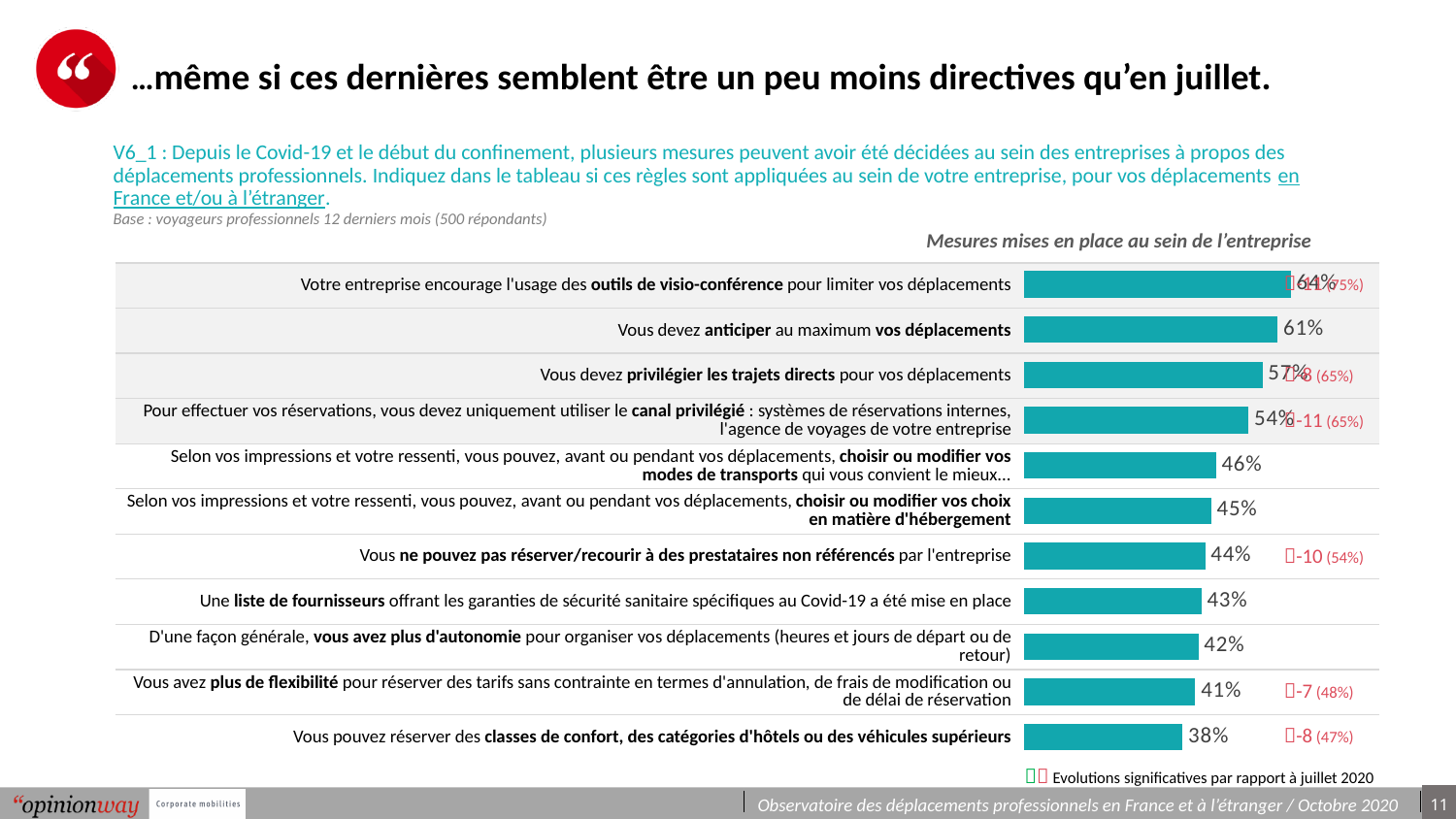
Which measure has the lowest percentage in the chart? Vous pouvez réserver des classes de confort, des catégories d'hôtels ou des véhicules supérieurs How many measures (bars) are shown in the chart? 11 What percentage is shown for the measure about booking superior comfort classes, hotel categories or vehicles (classes de confort)? 38% What is the value for 'Vous devez anticiper au maximum vos déplacements'? 61% What type of chart is used on this slide? Bar chart What is the title shown above the chart? Mesures mises en place au sein de l'entreprise Which has a higher value: 'canal privilégié' for reservations or 'plus d'autonomie' for organising travel? canal privilégié Which measure has the highest percentage in the chart? Votre entreprise encourage l'usage des outils de visio-conférence pour limiter vos déplacements What is the value for 'ne pouvez pas réserver/recourir à des prestataires non référencés'? 44% What is the value for the measure about a list of suppliers (liste de fournisseurs) offering Covid-19 sanitary guarantees? 43% What is the difference between the value for 'privilégier les trajets directs' and the value for 'plus de flexibilité'? 16 percentage points What percentage of respondents say their company encourages the use of video-conferencing tools (outils de visio-conférence) to limit travel? 64%